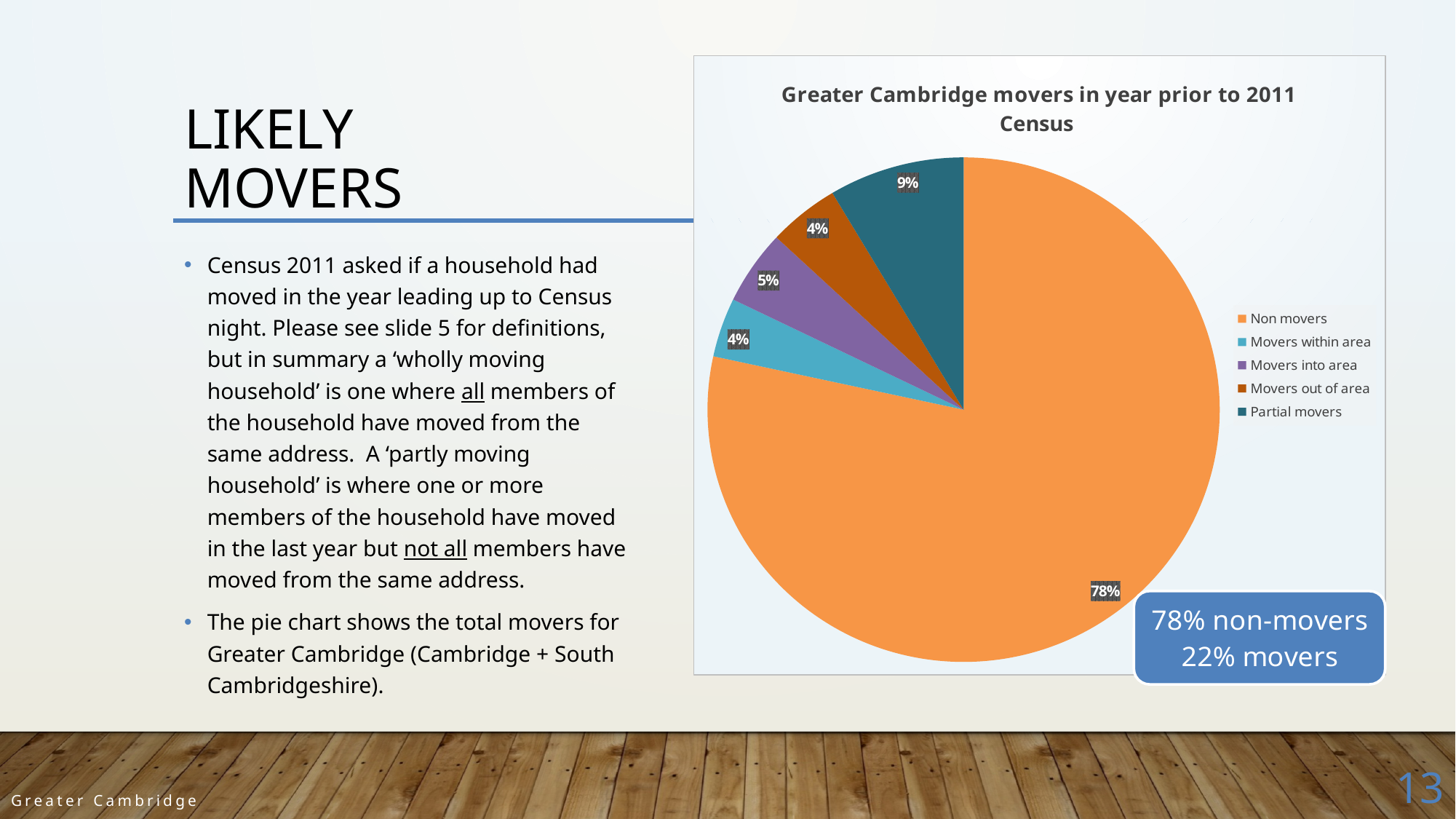
What is the difference in percentage points between the Non movers slice and the Partial movers slice? 69 What share of the pie is Movers within area? 4% How many categories does the legend of the pie chart list? 5 What share of the pie is Partial movers? 9% What kind of chart is shown on the slide? pie chart Which category has the largest slice of the pie? Non movers What share of the pie is Movers into area? 5% Which is larger, the slice for Partial movers or the slice for Movers into area? Partial movers What colour is the Non movers slice of the pie? orange What is the title of the chart? Greater Cambridge movers in year prior to 2011 Census